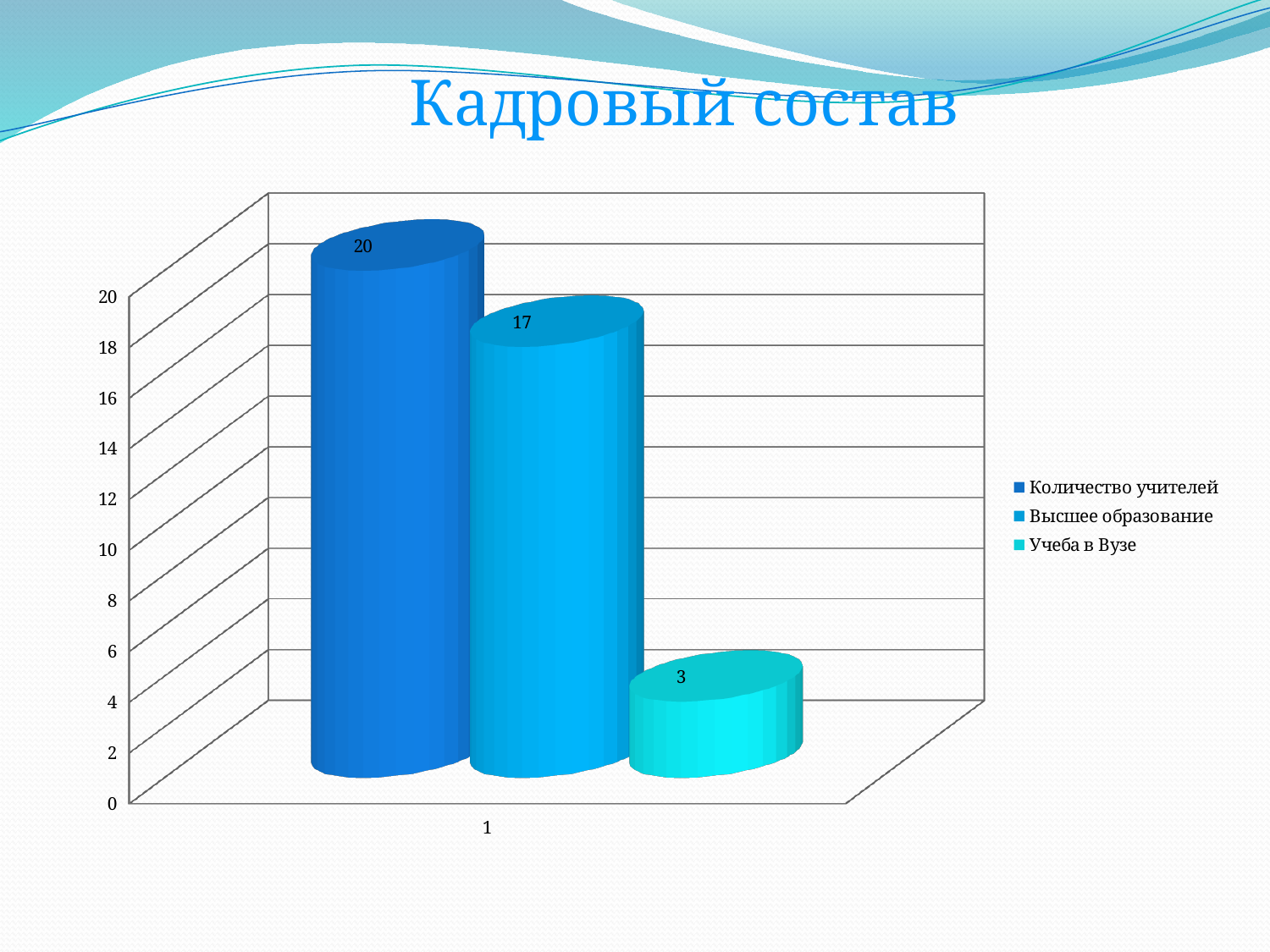
What is the value for Количество учителей? 20 What is the value for Учеба в Вузе? 3 Which series has the lowest value? Учеба в Вузе What is the difference between Высшее образование and Учеба в Вузе? 14 Which is larger, Высшее образование or Учеба в Вузе? Высшее образование What kind of chart is shown on the slide? bar chart What is the difference between Количество учителей and Высшее образование? 3 Which series has the highest value? Количество учителей How many series does the legend list? 3 Is the value for Высшее образование greater or less than 10? greater What is the value for Высшее образование? 17 What is the title of the slide? Кадровый состав